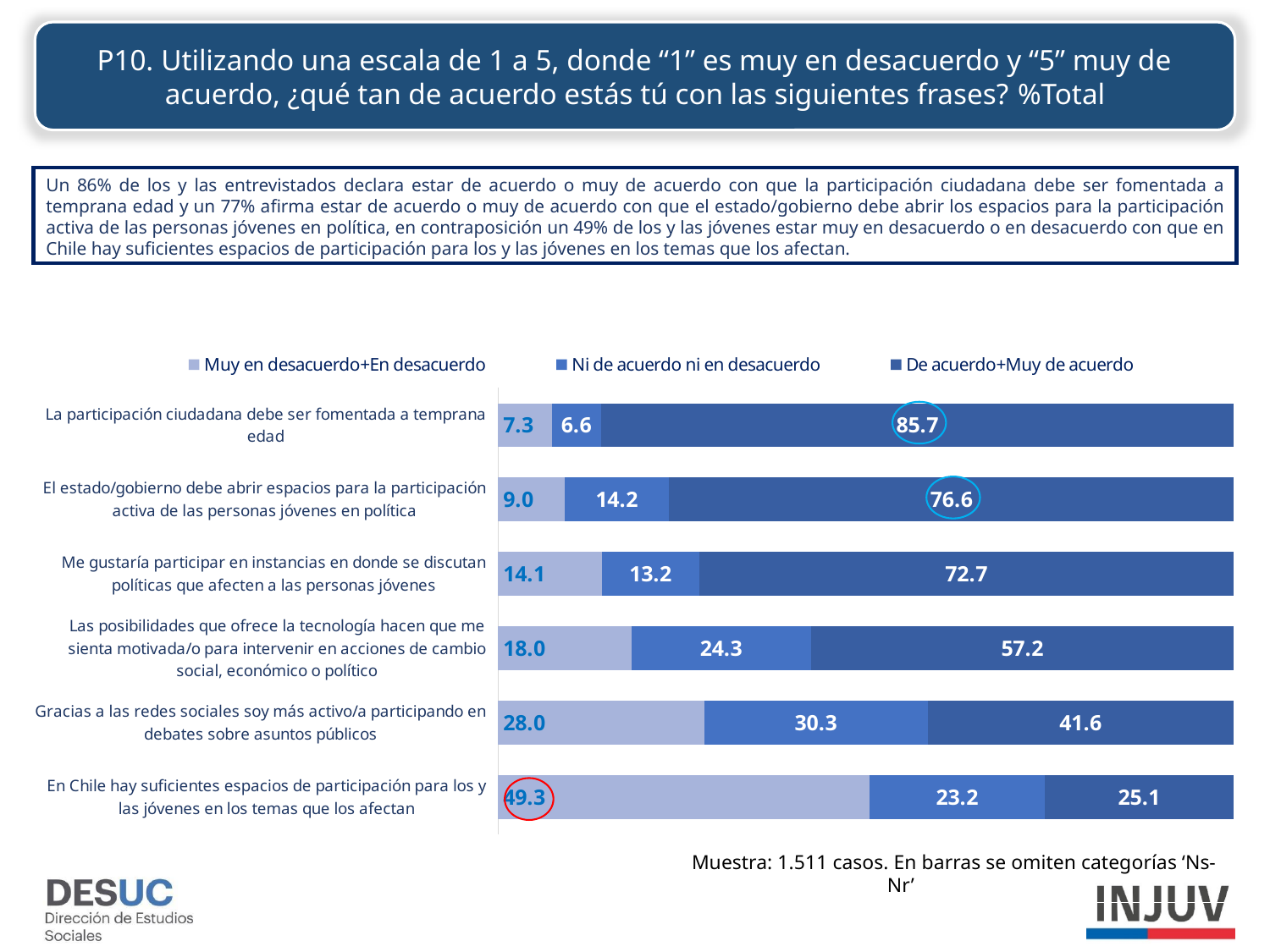
Which is larger for 'Las posibilidades que ofrece la tecnología hacen que me sienta motivada/o para intervenir en acciones de cambio social, económico o político': the 'Ni de acuerdo ni en desacuerdo' value or the 'Muy en desacuerdo+En desacuerdo' value? Ni de acuerdo ni en desacuerdo Which statement has the lowest 'Muy en desacuerdo+En desacuerdo' value? La participación ciudadana debe ser fomentada a temprana edad What type of chart is shown on the slide? Stacked bar chart What is the 'De acuerdo+Muy de acuerdo' value for 'La participación ciudadana debe ser fomentada a temprana edad'? 85.7 How many statements (categories) are plotted in the chart? 6 What is the difference between the 'De acuerdo+Muy de acuerdo' values for 'Me gustaría participar en instancias en donde se discutan políticas que afecten a las personas jóvenes' and 'Gracias a las redes sociales soy más activo/a participando en debates sobre asuntos públicos'? 31.1 What is the 'Ni de acuerdo ni en desacuerdo' value for 'El estado/gobierno debe abrir espacios para la participación activa de las personas jóvenes en política'? 14.2 Which legend entry is shown in the darkest blue colour? De acuerdo+Muy de acuerdo What is the total of the three segments for 'Gracias a las redes sociales soy más activo/a participando en debates sobre asuntos públicos'? 99.9 Which statement has the highest 'De acuerdo+Muy de acuerdo' value? La participación ciudadana debe ser fomentada a temprana edad How many series does the legend list? 3 What is the 'Muy en desacuerdo+En desacuerdo' value for 'En Chile hay suficientes espacios de participación para los y las jóvenes en los temas que los afectan'? 49.3